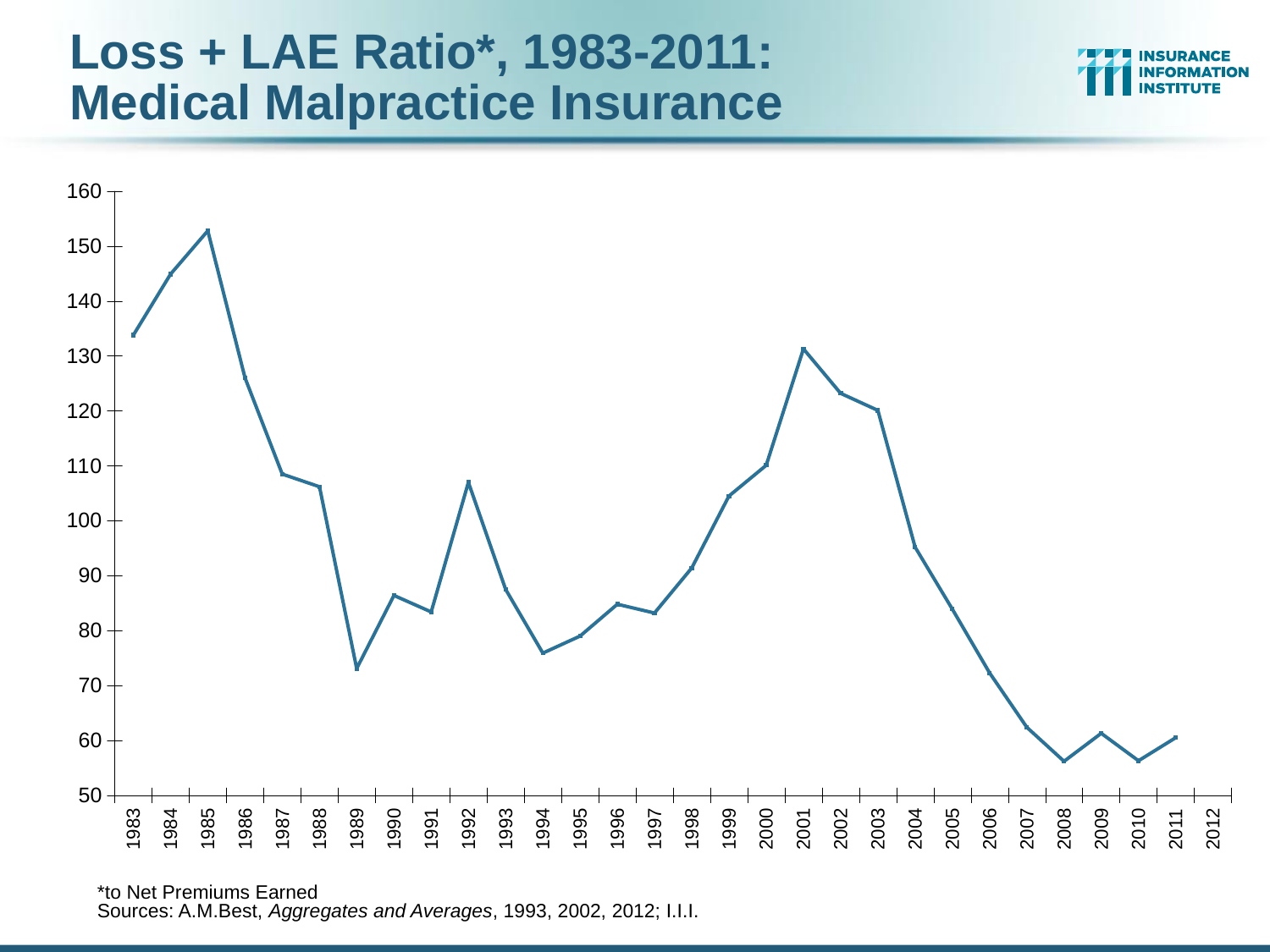
According to the footnote, what is the Loss + LAE Ratio measured relative to? Net Premiums Earned Is the value for 1992 greater or less than 100? greater Which year has the highest Loss + LAE Ratio? 1985 Is the value for 1994 greater or less than 80? less Does the Loss + LAE Ratio rise or fall from 2001 to 2008? fall Is the value for 1986 greater or less than 120? greater Does the Loss + LAE Ratio rise or fall from 1994 to 2001? rise What kind of chart is shown on the slide? line chart Which year has the larger value, 1985 or 2001? 1985 Which year has the larger value, 1989 or 1992? 1992